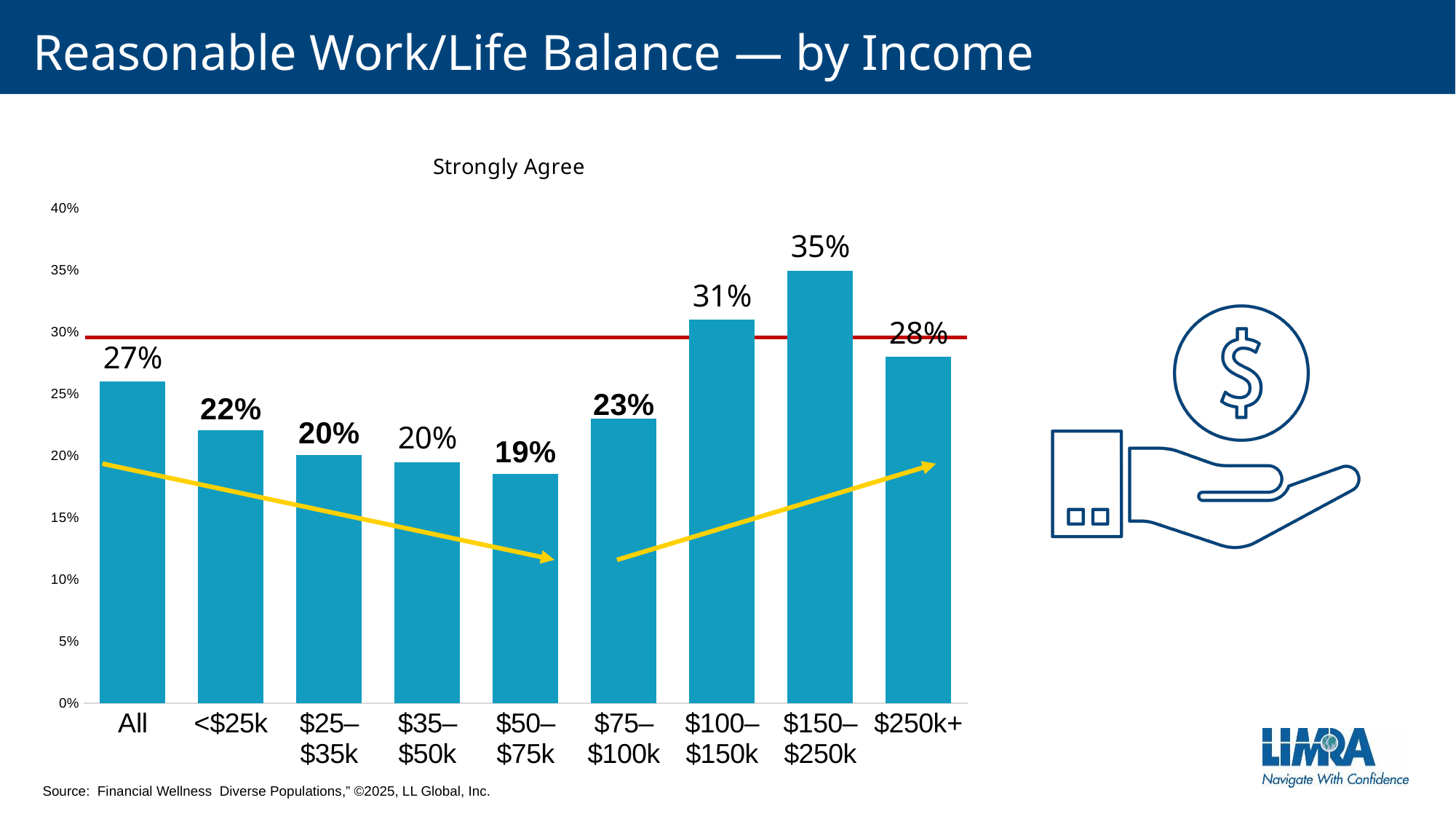
Is the value for $75–$100k greater or less than 30%? less What is the title shown above the chart? Strongly Agree Which income group has the lowest value? $50–$75k What is the value for the All category? 27% What is the value for the $250k+ income group? 28% How many categories are shown on the x axis? 9 Which income group has the highest value? $150–$250k Which is larger, the value for $100–$150k or the value for $250k+? $100–$150k What is the difference between the $150–$250k group and the $50–$75k group? 16 percentage points What is the value for the $50–$75k income group? 19% What is the value for the $150–$250k income group? 35% What kind of chart is shown on the slide? Bar chart